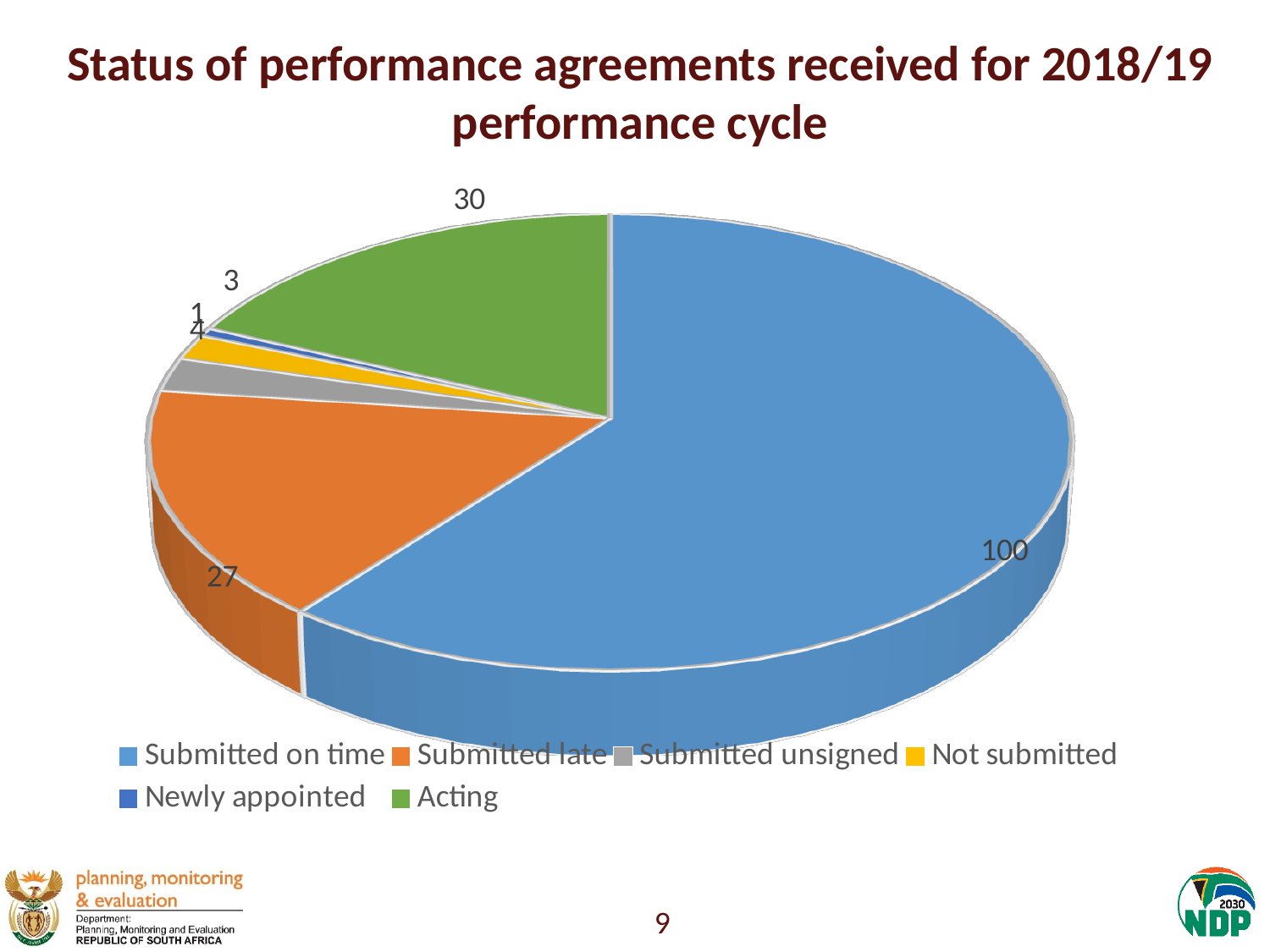
What is the difference between Submitted on time and Submitted late? 73 What type of chart is shown on the slide? Pie chart Which is larger, Submitted late or Acting? Acting Which category has the largest slice of the pie? Submitted on time What is the value for Submitted on time? 100 What is the value for Submitted late? 27 What is the difference between Submitted on time and Acting? 70 How many categories does the legend list? 6 What colour is the Acting slice? Green What is the value for Acting? 30 Which category has the smallest slice of the pie? Newly appointed What is the title of the chart? Status of performance agreements received for 2018/19 performance cycle